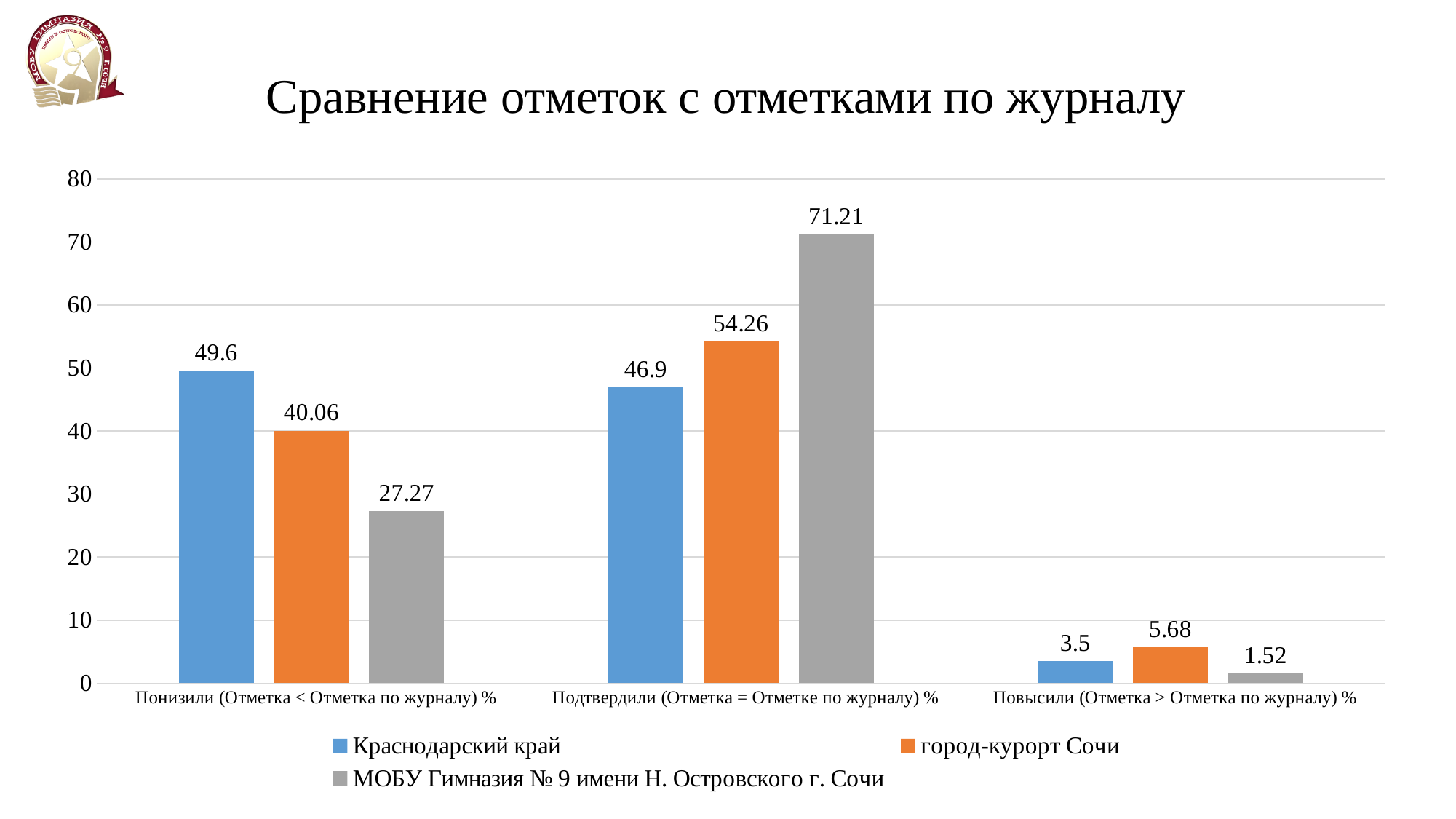
Which series has the lowest value in the category Понизили (Отметка < Отметка по журналу) %? МОБУ Гимназия № 9 имени Н. Островского г. Сочи What is the value for Краснодарский край in the category Понизили (Отметка < Отметка по журналу) %? 49.6 How many categories are shown on the x axis? 3 What is the title of the chart? Сравнение отметок с отметками по журналу What is the value for город-курорт Сочи in the category Повысили (Отметка > Отметка по журналу) %? 5.68 What kind of chart is shown on the slide? bar chart How many series does the legend list? 3 Which series has the highest value in the category Подтвердили (Отметка = Отметке по журналу) %? МОБУ Гимназия № 9 имени Н. Островского г. Сочи What is the value for МОБУ Гимназия № 9 имени Н. Островского г. Сочи in the category Подтвердили (Отметка = Отметке по журналу) %? 71.21 Which is larger: the value for Краснодарский край or for город-курорт Сочи in the category Понизили (Отметка < Отметка по журналу) %? Краснодарский край What is the difference between the values for город-курорт Сочи and Краснодарский край in the category Подтвердили (Отметка = Отметке по журналу) %? 7.36 Is the value for МОБУ Гимназия № 9 имени Н. Островского г. Сочи in the category Понизили (Отметка < Отметка по журналу) % greater or less than 30? less